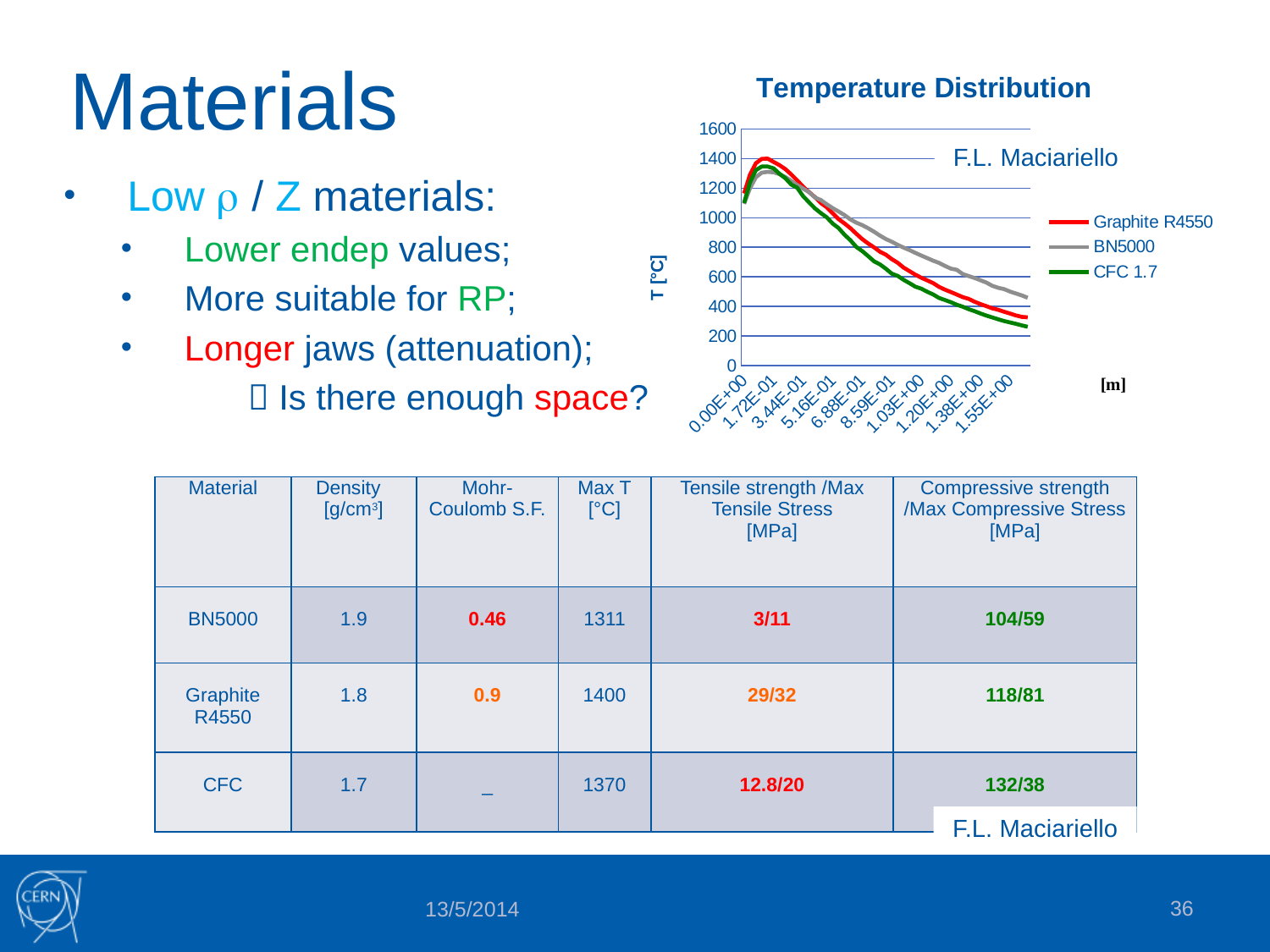
In the Temperature Distribution chart, which series has the lowest value at 1.55E+00 m? CFC 1.7 In the Temperature Distribution chart, is the value for BN5000 at 1.55E+00 m greater or less than 400? greater In the Temperature Distribution chart, which series reaches the highest peak temperature? Graphite R4550 In the Temperature Distribution chart, is the value for CFC 1.7 at 1.55E+00 m greater or less than 400? less What is the label of the vertical axis of the Temperature Distribution chart? T [°C] What is the title of the chart on the slide? Temperature Distribution What kind of chart is the Temperature Distribution chart? line chart In the Temperature Distribution chart, at 1.55E+00 m, which series has the larger value, BN5000 or CFC 1.7? BN5000 In the Temperature Distribution chart, do the values for BN5000 rise or fall from 3.44E-01 m to 1.55E+00 m? fall In the Temperature Distribution chart, is the peak value for Graphite R4550 greater or less than 1200? greater How many tick labels are shown on the x axis of the Temperature Distribution chart? 10 How many series does the legend of the Temperature Distribution chart list? 3